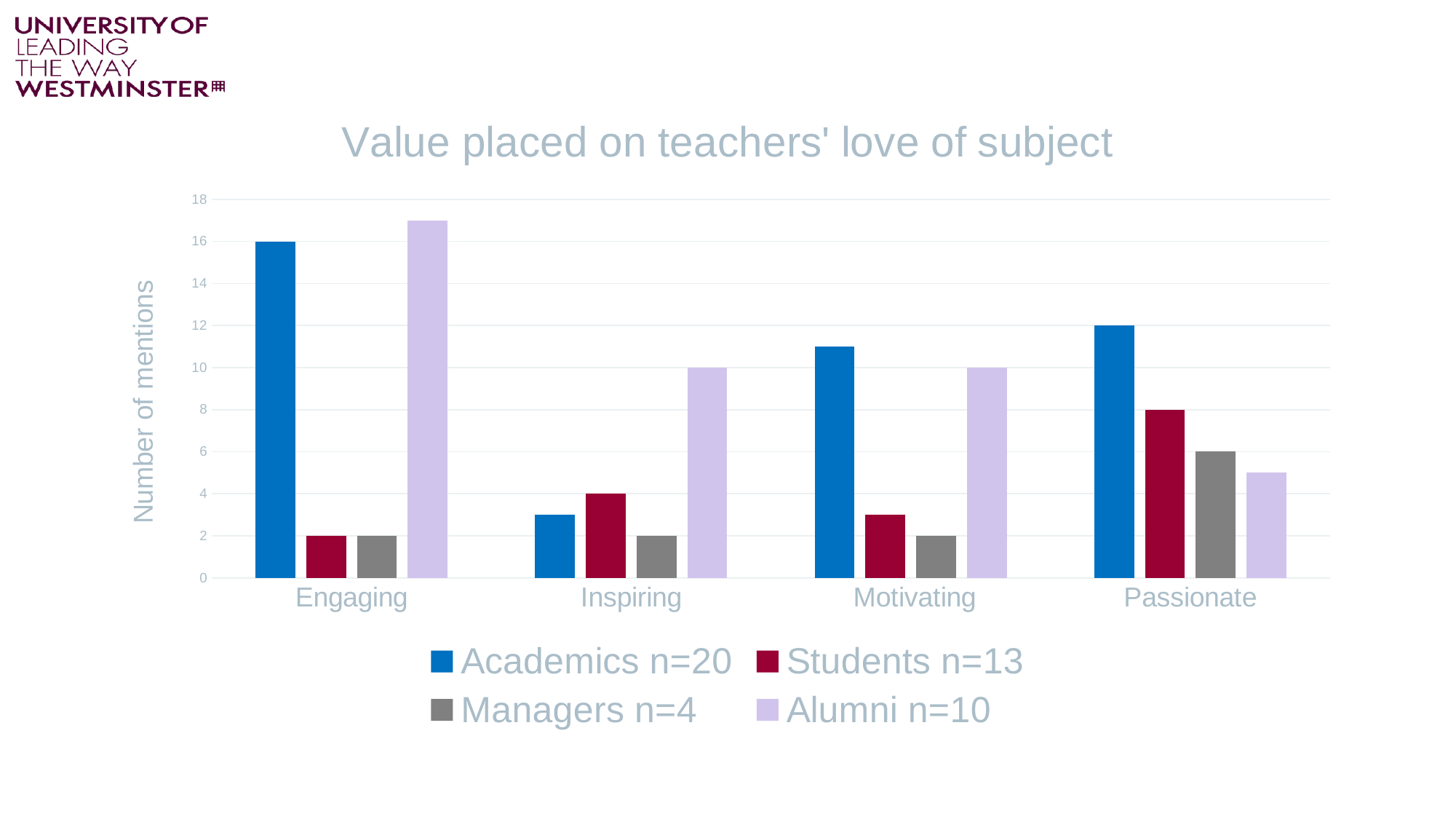
What is the number of mentions for Students in the Passionate category? 8 What type of chart is shown on the slide? bar chart What is the difference between the Academics and Students values in the Passionate category? 4 Which series has the highest value in the Passionate category? Academics n=20 Is the value for Academics in the Motivating category greater or less than 10? greater How many series does the legend list? 4 What is the number of mentions for Academics in the Engaging category? 16 Is the value for Alumni in the Engaging category greater or less than 16? greater How many categories are shown on the x axis? 4 What is the number of mentions for Managers in the Passionate category? 6 What is the title of the chart? Value placed on teachers' love of subject What is the number of mentions for Alumni in the Inspiring category? 10